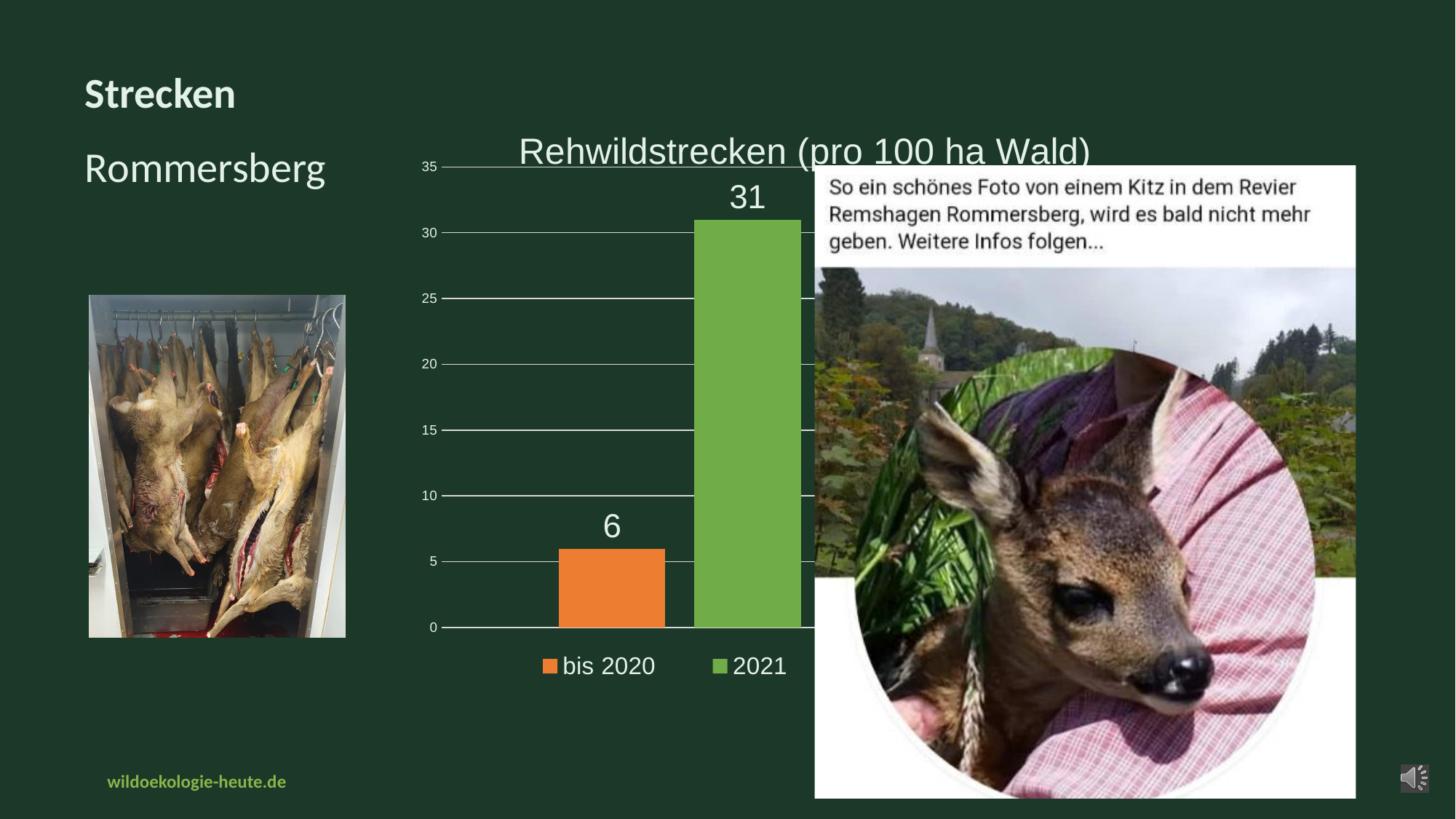
What is the value for 'bis 2020' in the Rehwildstrecken chart? 6 Which is larger in the Rehwildstrecken chart: the value for 'bis 2020' or the value for 2021? 2021 What is the value for '2021' in the Rehwildstrecken chart? 31 What is the title of the chart on the slide? Rehwildstrecken (pro 100 ha Wald) What colour is the bar for 2021 in the Rehwildstrecken chart? green Which series has the highest value in the Rehwildstrecken chart? 2021 Is the value for 'bis 2020' in the Rehwildstrecken chart greater or less than 10? less What kind of chart is the Rehwildstrecken chart? bar chart Which series has the lowest value in the Rehwildstrecken chart? bis 2020 What is the difference between the 2021 value and the 'bis 2020' value in the Rehwildstrecken chart? 25 Is the value for 2021 in the Rehwildstrecken chart greater or less than 30? greater